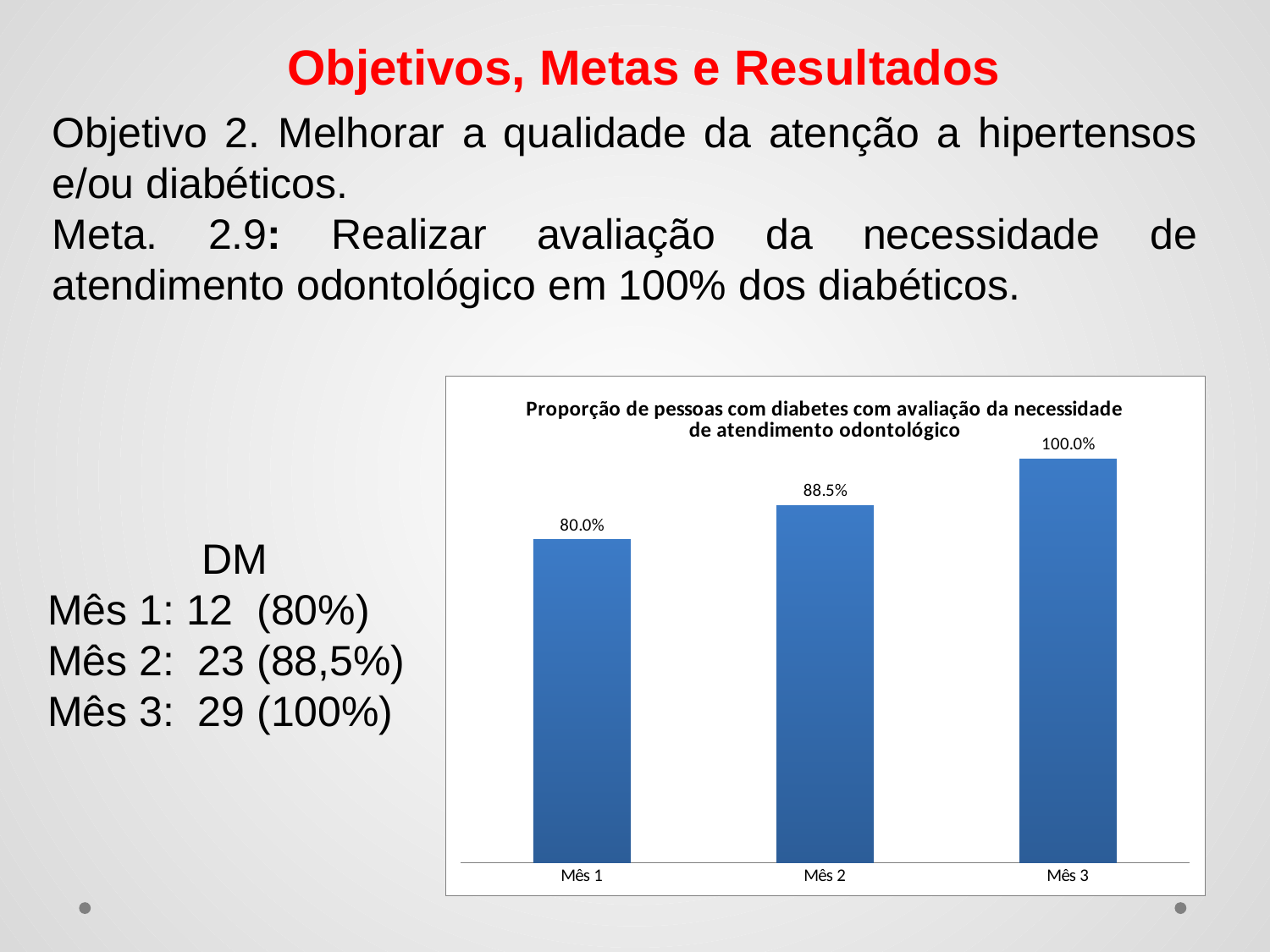
What is the title of the chart? Proporção de pessoas com diabetes com avaliação da necessidade de atendimento odontológico What is the value for Mês 3? 100.0% Do the values rise or fall from Mês 1 to Mês 3? Rise What is the difference between the values for Mês 3 and Mês 1? 20.0% Which month has the lowest value? Mês 1 What is the value for Mês 1? 80.0% What kind of chart is shown? Bar chart What is the value for Mês 2? 88.5% Which is larger, the value for Mês 2 or the value for Mês 3? Mês 3 What is the difference between the values for Mês 2 and Mês 1? 8.5% How many months are shown on the x axis? 3 Which month has the highest value? Mês 3